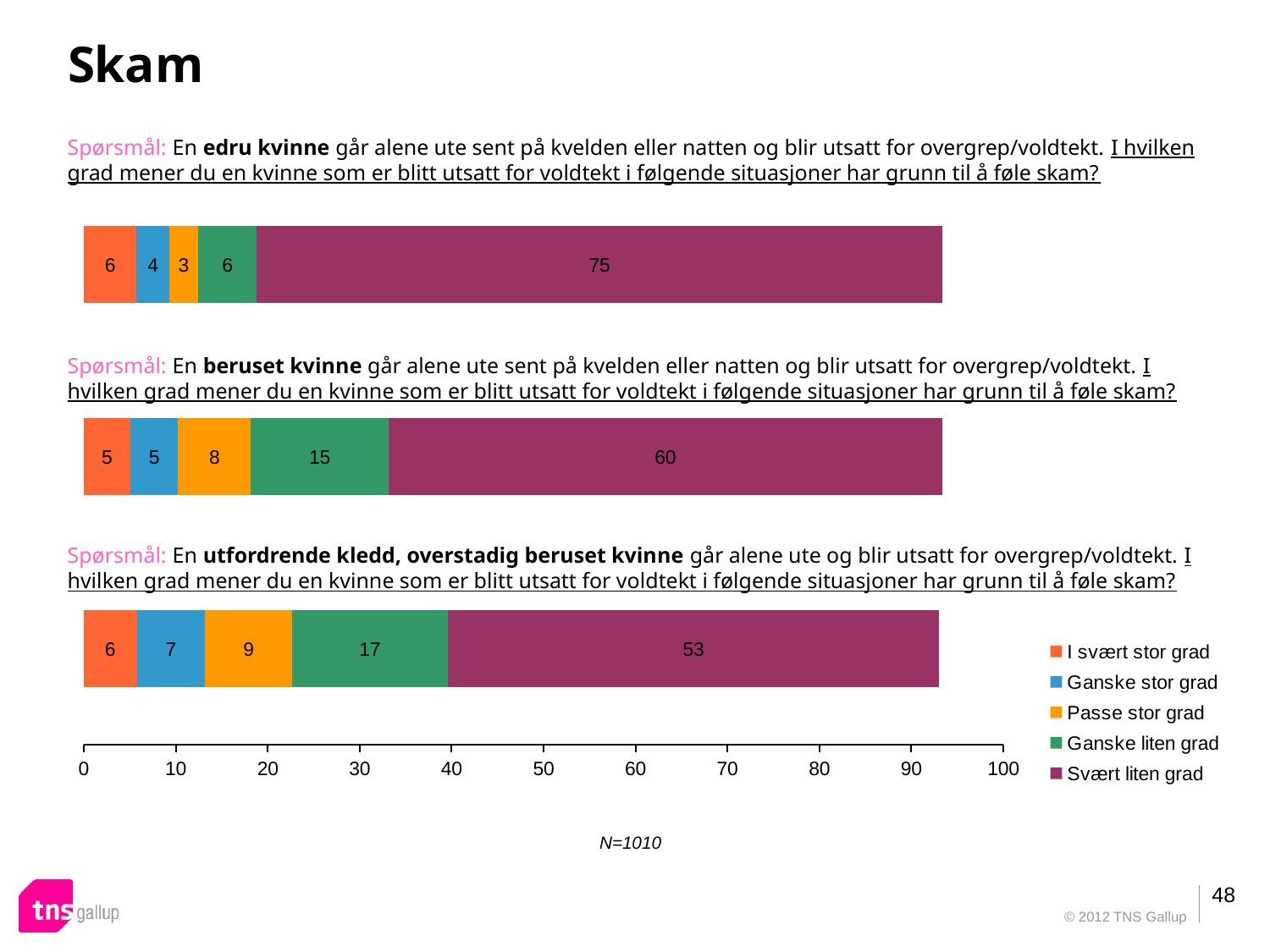
What kind of chart is used on this slide? Stacked bar chart What is the total of the stacked bar in the bottom chart (utfordrende kledd, overstadig beruset kvinne)? 92 In the top chart (edru kvinne), what is the value for 'Svært liten grad'? 75 In the bottom chart (utfordrende kledd, overstadig beruset kvinne), what is the value for 'Svært liten grad'? 53 How many series does the legend list? 5 In the top chart (edru kvinne), which response category has the highest value? Svært liten grad In the middle chart (beruset kvinne), is the value for 'Svært liten grad' greater or less than 50? greater In the middle chart (beruset kvinne), what is the value for 'Ganske liten grad'? 15 In the middle chart (beruset kvinne), what is the difference between 'Svært liten grad' and 'Ganske liten grad'? 45 In the bottom chart (utfordrende kledd, overstadig beruset kvinne), what is the value for 'Passe stor grad'? 9 What is the total of the stacked bar in the top chart (edru kvinne)? 94 Which is larger: 'Svært liten grad' in the top chart (edru kvinne) or 'Svært liten grad' in the bottom chart (utfordrende kledd, overstadig beruset kvinne)? Top chart (edru kvinne), 75